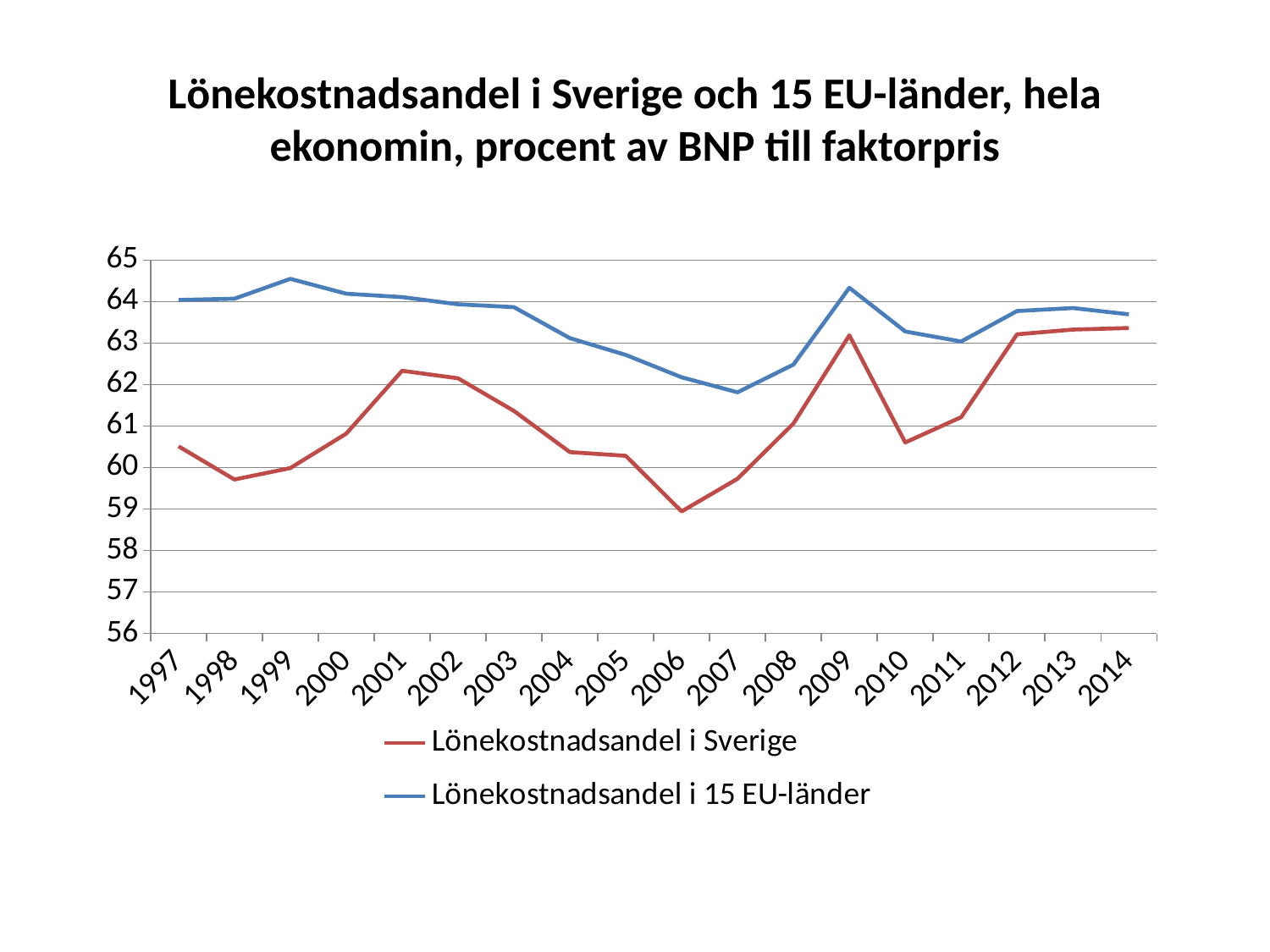
Does the value for Lönekostnadsandel i Sverige rise or fall from 2006 to 2009? rise How many series does the legend list? 2 In 2010, which series has the higher value, Lönekostnadsandel i Sverige or Lönekostnadsandel i 15 EU-länder? Lönekostnadsandel i 15 EU-länder Is the value for Lönekostnadsandel i 15 EU-länder in 2007 greater or less than 62? less How many years are plotted along the x axis? 18 Is the value for Lönekostnadsandel i Sverige in 2001 greater or less than 62? greater Is the value for Lönekostnadsandel i 15 EU-länder in 1999 greater or less than 64? greater In which year is the value for Lönekostnadsandel i 15 EU-länder lowest? 2007 Does the value for Lönekostnadsandel i 15 EU-länder rise or fall from 1999 to 2007? fall What kind of chart is shown on the slide? line chart In which year is the value for Lönekostnadsandel i Sverige lowest? 2006